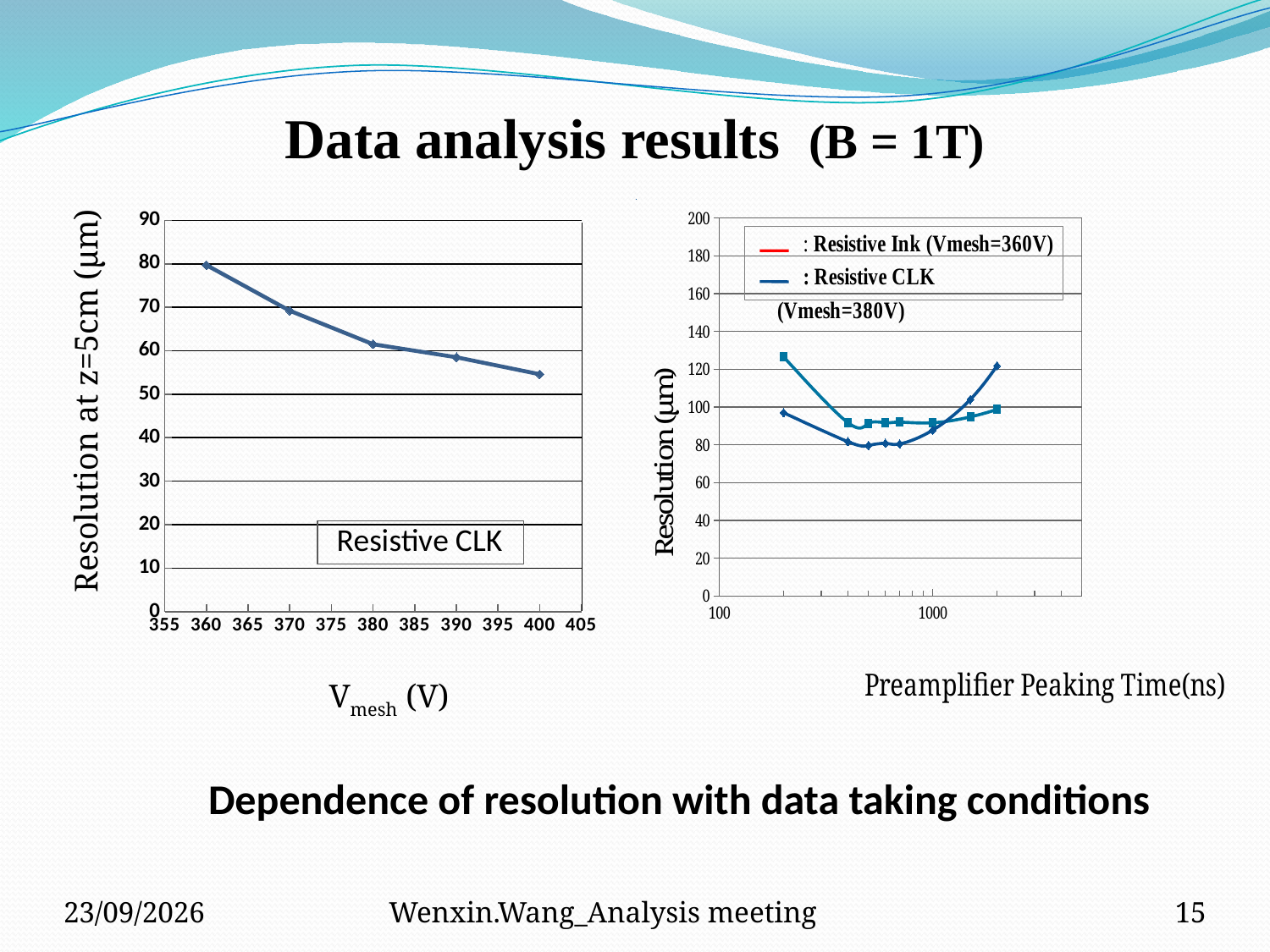
In the left chart, which has the larger resolution: Vmesh = 370 V or Vmesh = 390 V? 370 V In the right chart, is the lowest Resistive CLK resolution value greater or less than 100? less In the left chart, at which Vmesh value is the resolution highest? 360 How many series does the legend of the right chart (Resolution vs Preamplifier Peaking Time) list? 2 In the left chart, is the resolution at Vmesh = 360 V greater or less than 70? greater In the right chart, what Vmesh value is given in the legend for Resistive Ink? 360V In the left chart, how many data points are plotted? 5 In the left chart, is the resolution at Vmesh = 400 V greater or less than 60? less In the left chart, at which Vmesh value is the resolution lowest? 400 What kind of chart is the left chart (Resistive CLK vs Vmesh)? line chart In the left chart, what is the label on the y axis? Resolution at z=5cm (μm) In the left chart, does the resolution rise or fall as Vmesh increases from 360 V to 400 V? fall